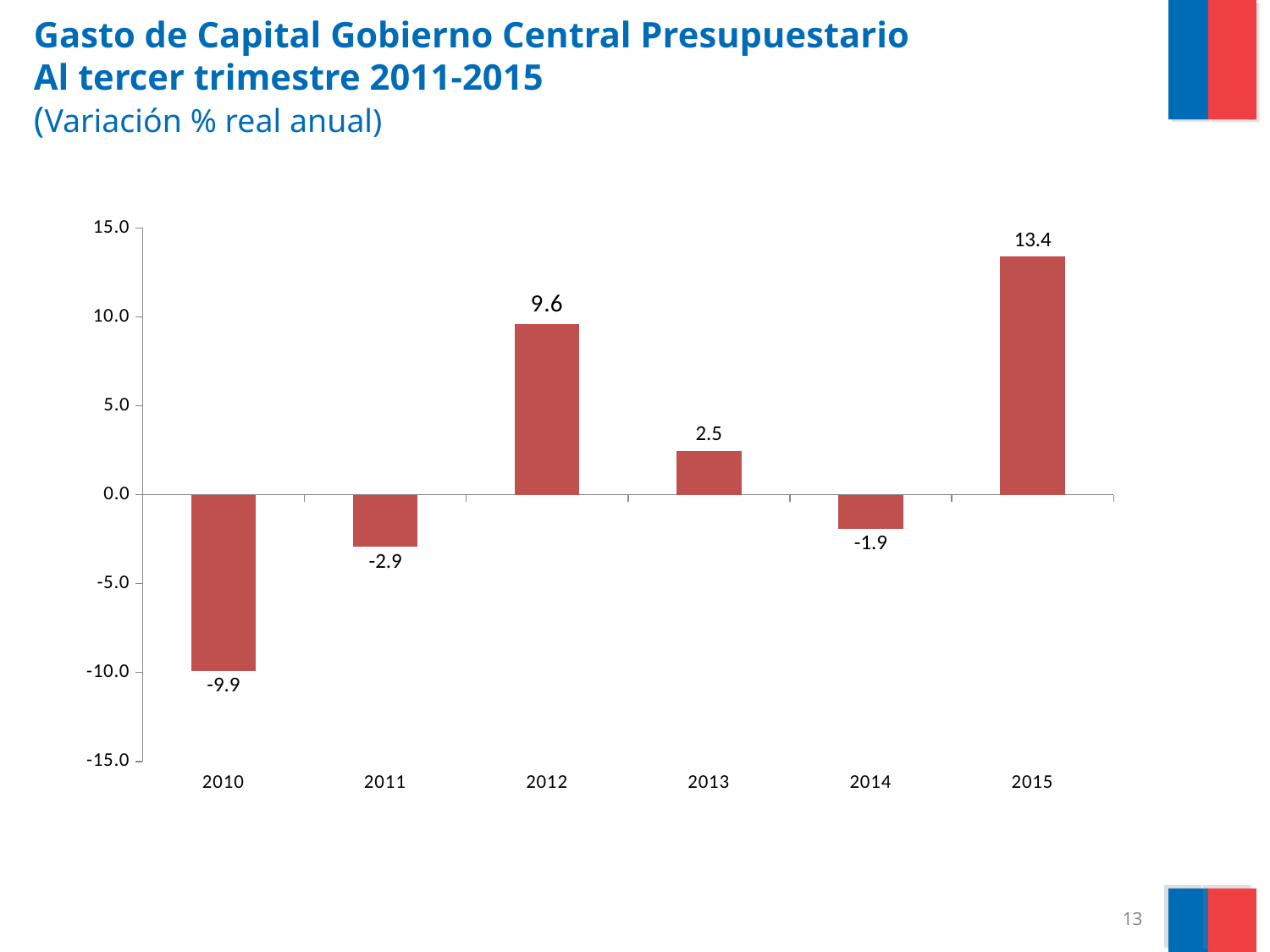
Which year has the highest value? 2015 What is the value for 2014? -1.9 What is the difference between the values for 2013 and 2011? 5.4 Which year has the lowest value? 2010 What is the difference between the values for 2015 and 2012? 3.8 How many years are shown on the x axis? 6 What kind of chart is shown on the slide? bar chart Is the value for 2015 greater or less than 10.0? greater What is the value for 2012? 9.6 What is the value for 2010? -9.9 Which is larger, the value for 2013 or the value for 2014? 2013 How many years show a negative value? 3